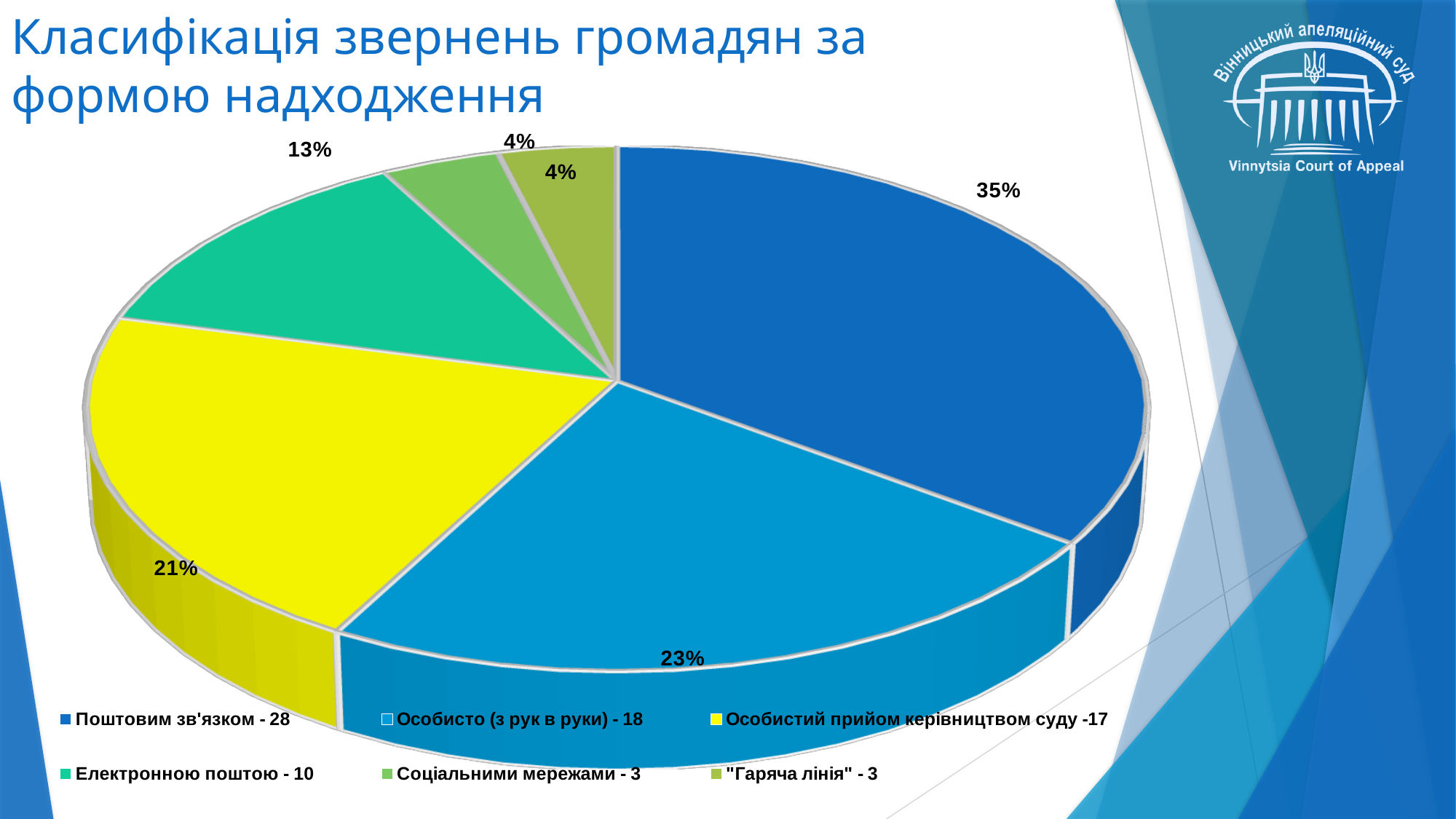
What is the difference in percentage points between the "Поштовим зв'язком" slice and the "Особисто (з рук в руки)" slice? 12% What percentage is shown for the slice "Особистий прийом керівництвом суду"? 21% What percentage is shown for the slice "Особисто (з рук в руки)"? 23% Which category has the largest slice of the pie? Поштовим зв'язком What percentage is shown for the slice "Соціальними мережами"? 4% How many categories (slices) does the pie chart have? 6 What share of the pie is "Електронною поштою"? 13% Which slice is larger: "Особистий прийом керівництвом суду" or "Електронною поштою"? Особистий прийом керівництвом суду What is the title of the chart on the slide? Класифікація звернень громадян за формою надходження According to the legend, how many appeals were received via "Електронною поштою"? 10 What percentage of the pie does the slice for "Поштовим зв'язком" represent? 35% What type of chart is shown on the slide? pie chart